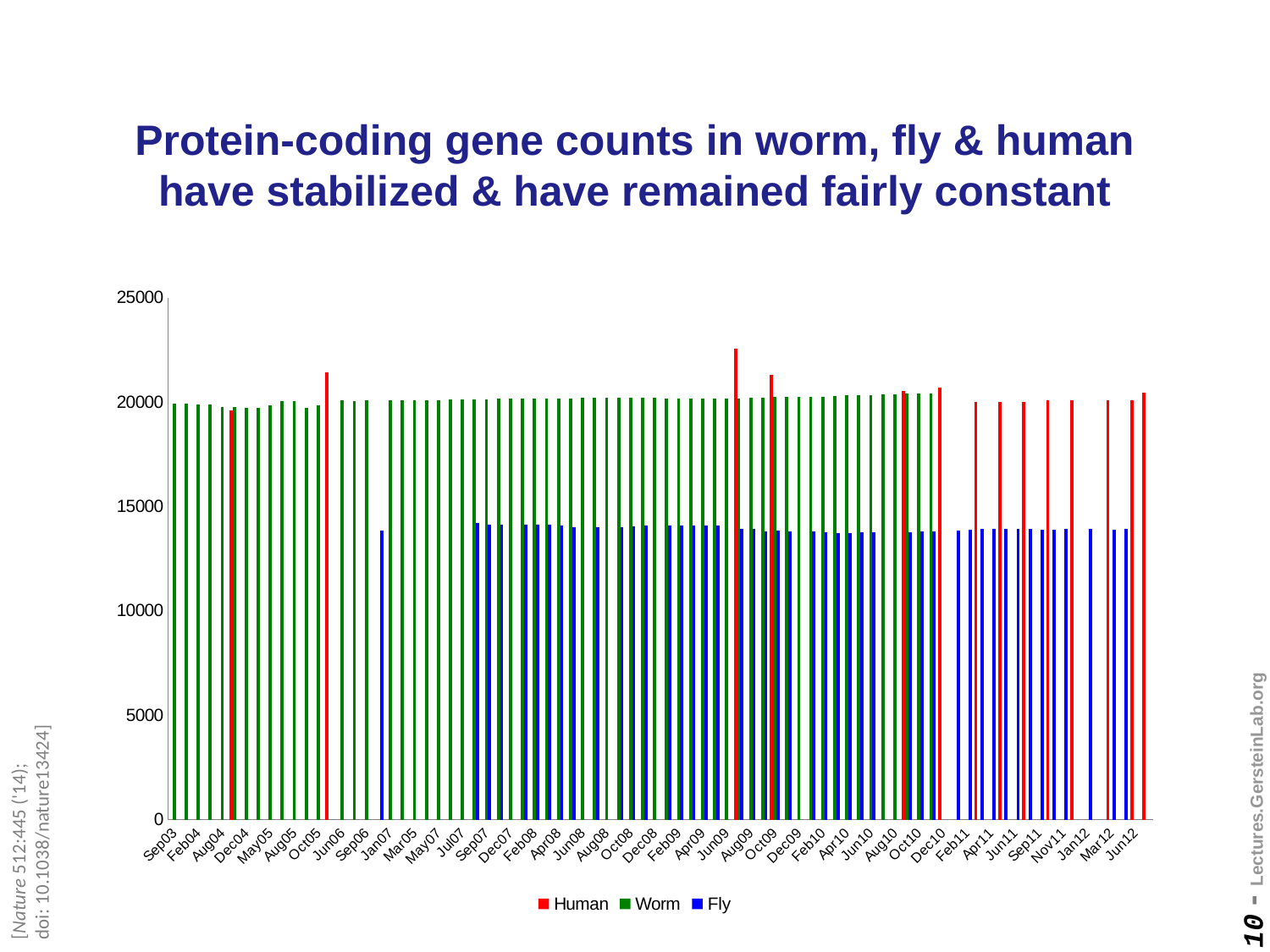
What colour represents the Fly series? blue How many series does the legend list? 3 Which is larger at Feb08, the Worm value or the Fly value? Worm Is the Worm value for Sep03 greater or less than 15000? greater What kind of chart is shown on the slide? bar chart Which series are listed in the legend? Human, Worm, Fly Which series reaches the highest value on the chart? Human Which series has the lowest values throughout the chart? Fly